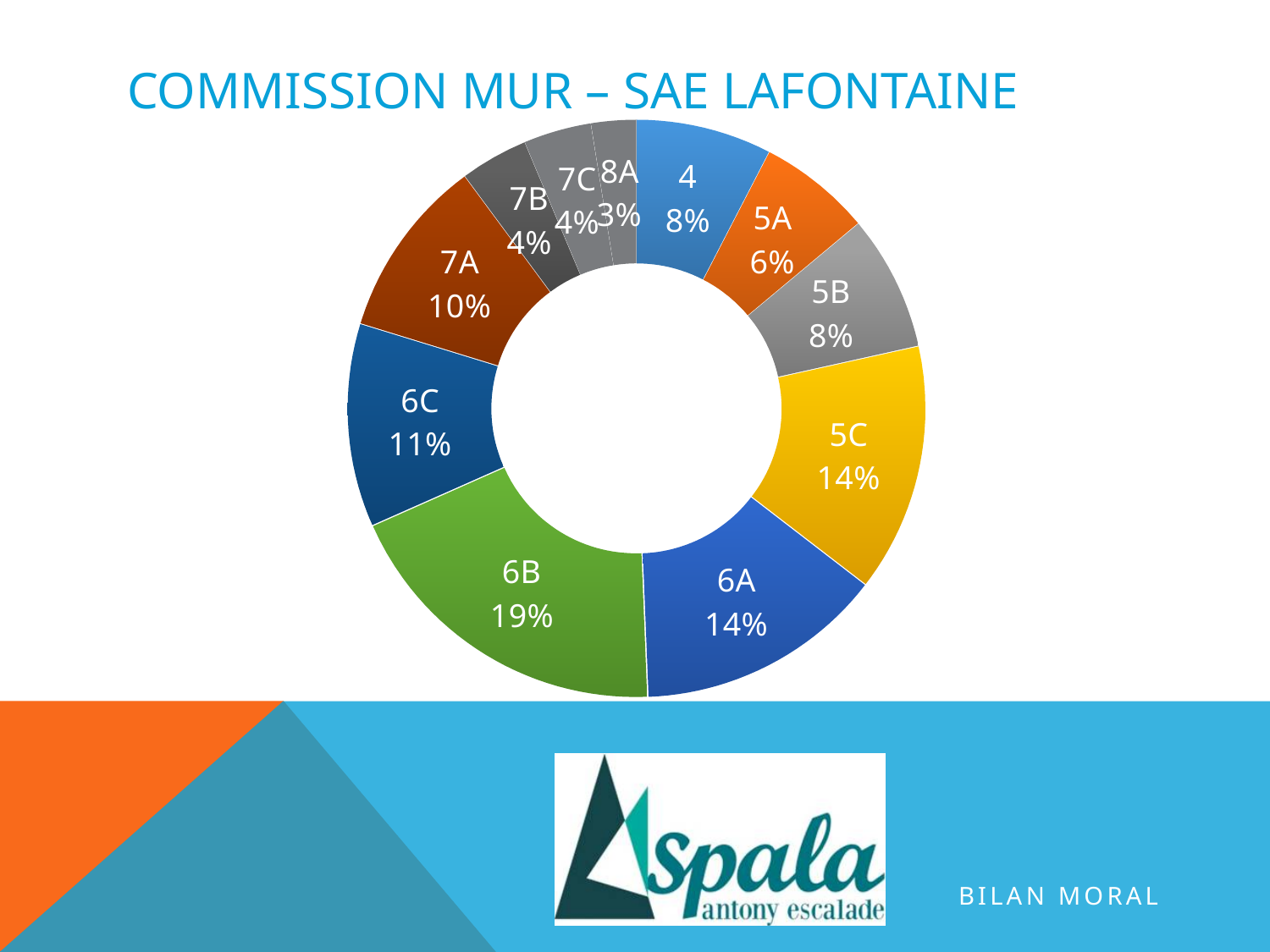
What colour is the 5C segment of the doughnut chart? yellow What percentage is shown for 7A? 10% What kind of chart is shown on the slide? doughnut chart Which category has the largest share of the doughnut chart? 6B What share of the doughnut chart does 6B represent? 19% Which category has the smallest share of the doughnut chart? 8A What percentage is shown for 5C? 14% What percentage is shown for 8A? 3% What is the title of the slide containing the chart? COMMISSION MUR – SAE LAFONTAINE Which has a larger share, 5A or 6C? 6C How many categories are shown in the doughnut chart? 11 What is the difference in percentage points between 6B and 6C? 8